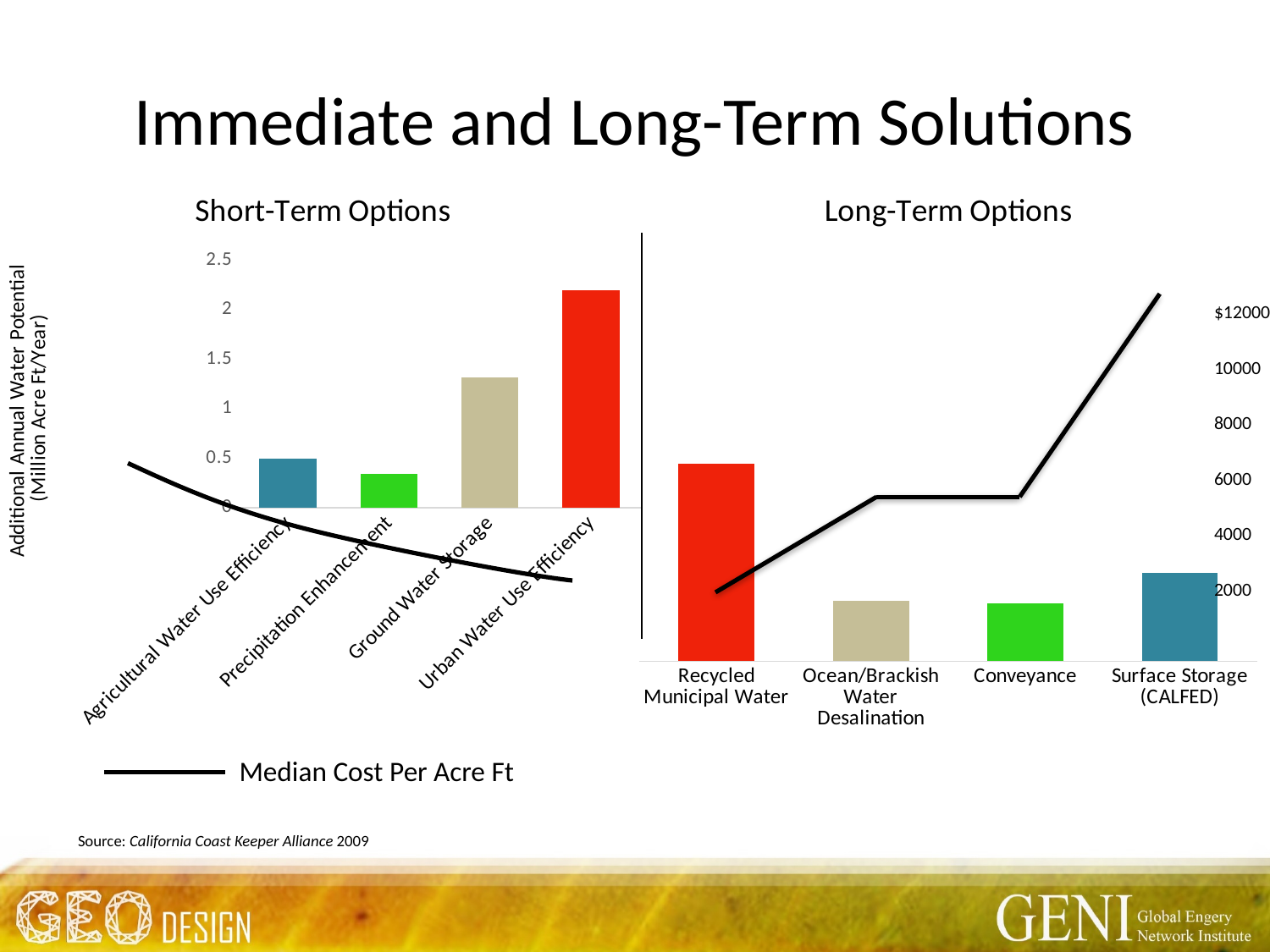
On the Long-Term Options chart, which category has the highest bar? Recycled Municipal Water On the Short-Term Options chart, does the Median Cost Per Acre Ft line rise or fall from left to right? fall On the Short-Term Options chart, how many categories are shown? 4 On the Long-Term Options chart, does the Median Cost Per Acre Ft line rise or fall from Recycled Municipal Water to Surface Storage (CALFED)? rise What is the label of the vertical axis on the left of the Short-Term Options chart? Additional Annual Water Potential (Million Acre Ft/Year) On the Short-Term Options chart, which category has the highest bar? Urban Water Use Efficiency On the Long-Term Options chart, which bar is taller: Surface Storage (CALFED) or Conveyance? Surface Storage (CALFED) On the Long-Term Options chart, is the median cost per acre ft for Surface Storage (CALFED) greater or less than 10000? greater On the Short-Term Options chart, is the value for Agricultural Water Use Efficiency greater or less than 1? less On the Short-Term Options chart, which category has the lowest bar? Precipitation Enhancement On the Short-Term Options chart, is the value for Urban Water Use Efficiency greater or less than 2? greater